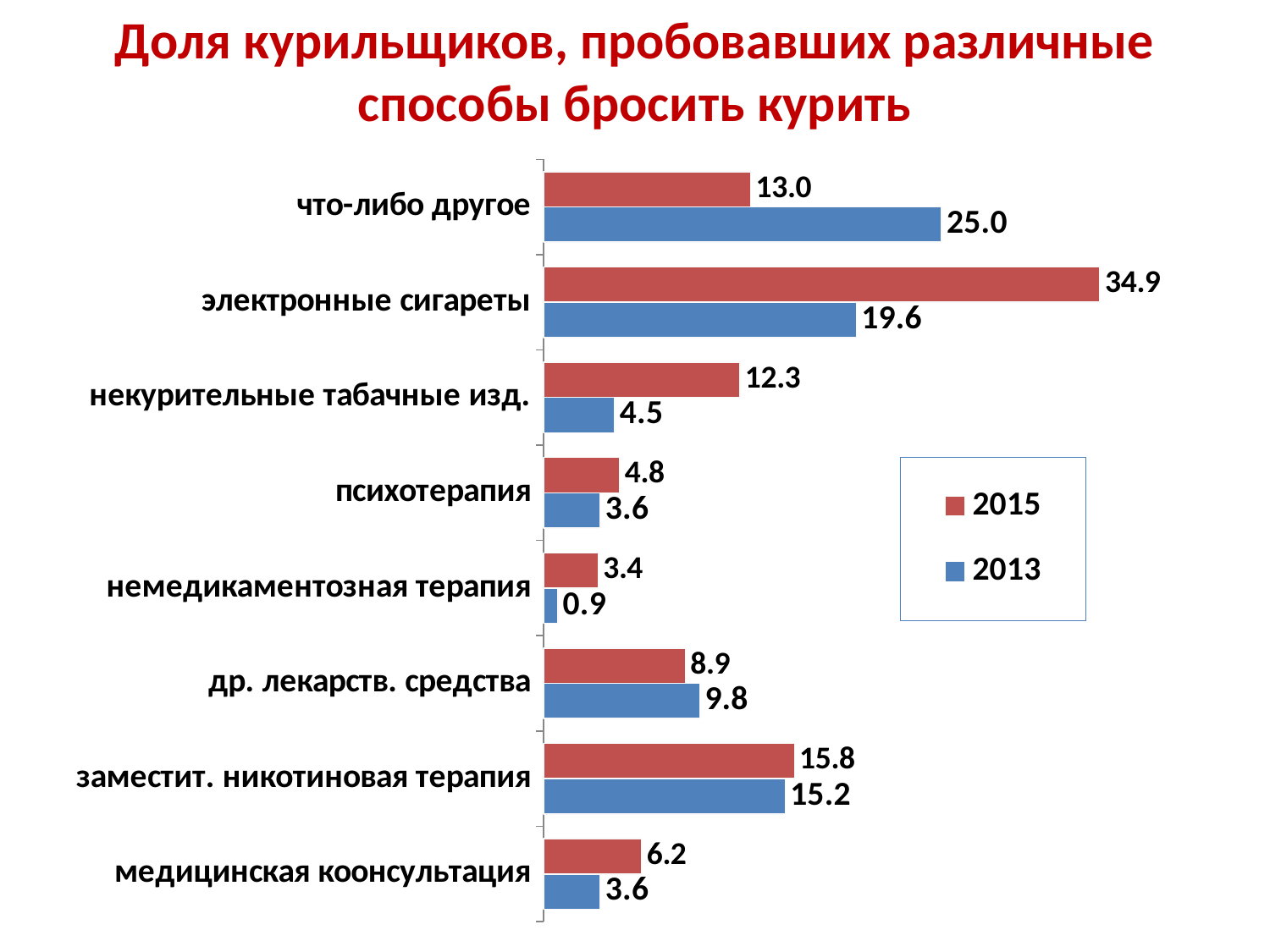
How many series does the legend list? 2 Which is larger for др. лекарств. средства, the 2015 value or the 2013 value? 2013 Which category has the highest 2015 value? электронные сигареты How many categories are shown on the chart? 8 What kind of chart is shown on the slide? bar chart What is the difference between the 2015 and 2013 values for некурительные табачные изд.? 7.8 What is the difference between the 2013 and 2015 values for что-либо другое? 12.0 Which category has the lowest 2013 value? немедикаментозная терапия What is the 2013 value for немедикаментозная терапия? 0.9 What is the 2013 value for что-либо другое? 25.0 What is the 2015 value for электронные сигареты? 34.9 Which colour represents the 2013 series? blue